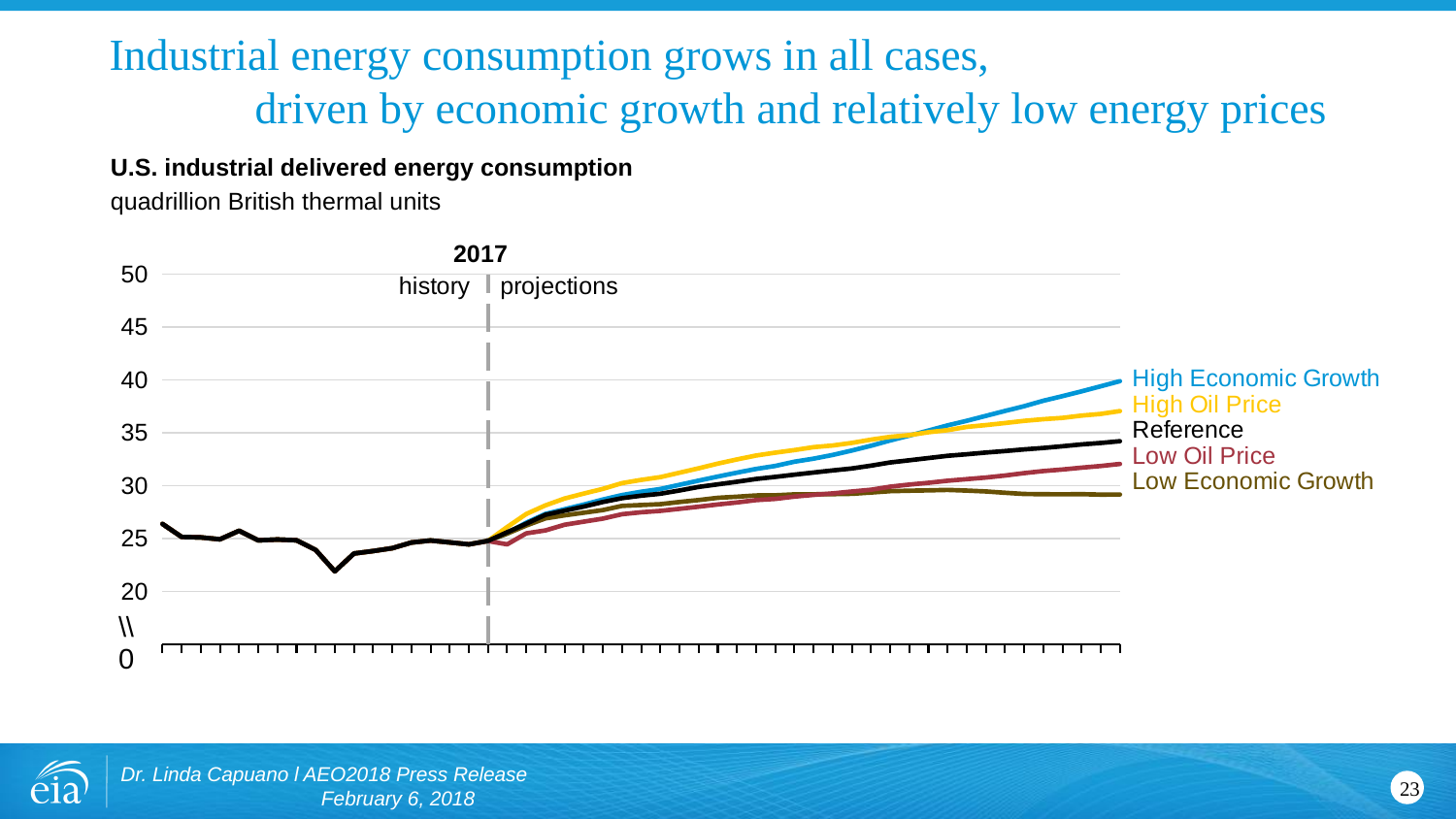
Which case has the highest value at the end of the projection period? High Economic Growth How many series (cases) are labelled on the chart? 5 What kind of chart is shown on the slide? line chart Is the value for High Economic Growth at the end of the projection period greater or less than 35? greater At the end of the projection period, which is larger: Reference or Low Oil Price? Reference Does the High Economic Growth line rise or fall over the projection period? rise At the end of the projection period, which is larger: High Economic Growth or High Oil Price? High Economic Growth Is the value for Low Oil Price at the end of the projection period greater or less than 35? less Is the value for High Oil Price at the end of the projection period greater or less than 35? greater What year separates history from projections on the chart? 2017 Which case has the lowest value at the end of the projection period? Low Economic Growth